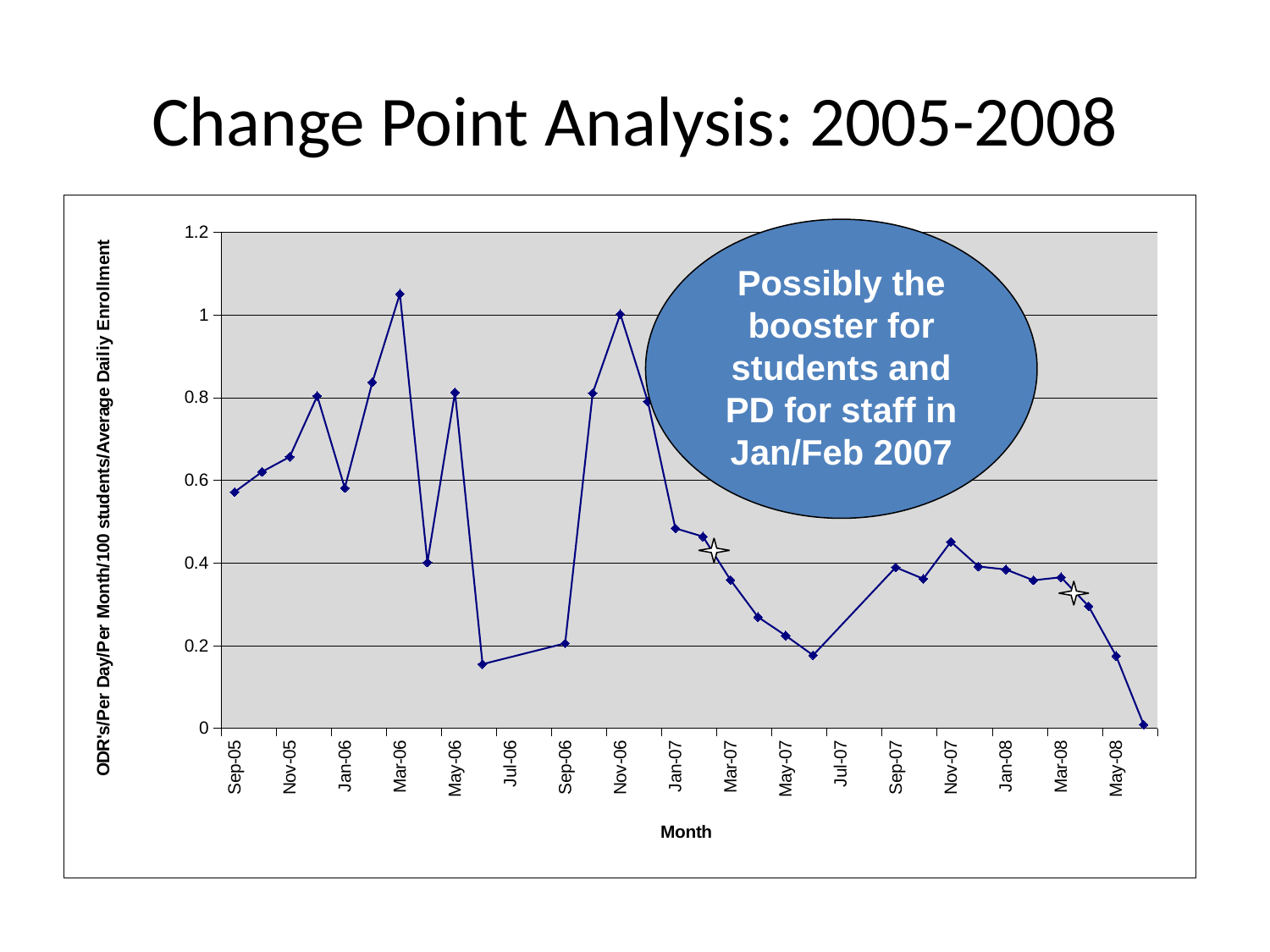
Which is larger, the value for Nov-06 or the value for Jan-07? Nov-06 What does the callout on the chart say? Possibly the booster for students and PD for staff in Jan/Feb 2007 Is the value for Mar-06 greater or less than 1? greater Do the values rise or fall from Jan-07 to Jun-07? fall Is the value for Mar-07 greater or less than 0.4? less What kind of chart is shown on the slide? line chart Which month has the lowest value on the chart? Jun-08 Which month has the highest value on the chart? Mar-06 What is the title of the x axis? Month Is the value for Jan-07 greater or less than 0.4? greater